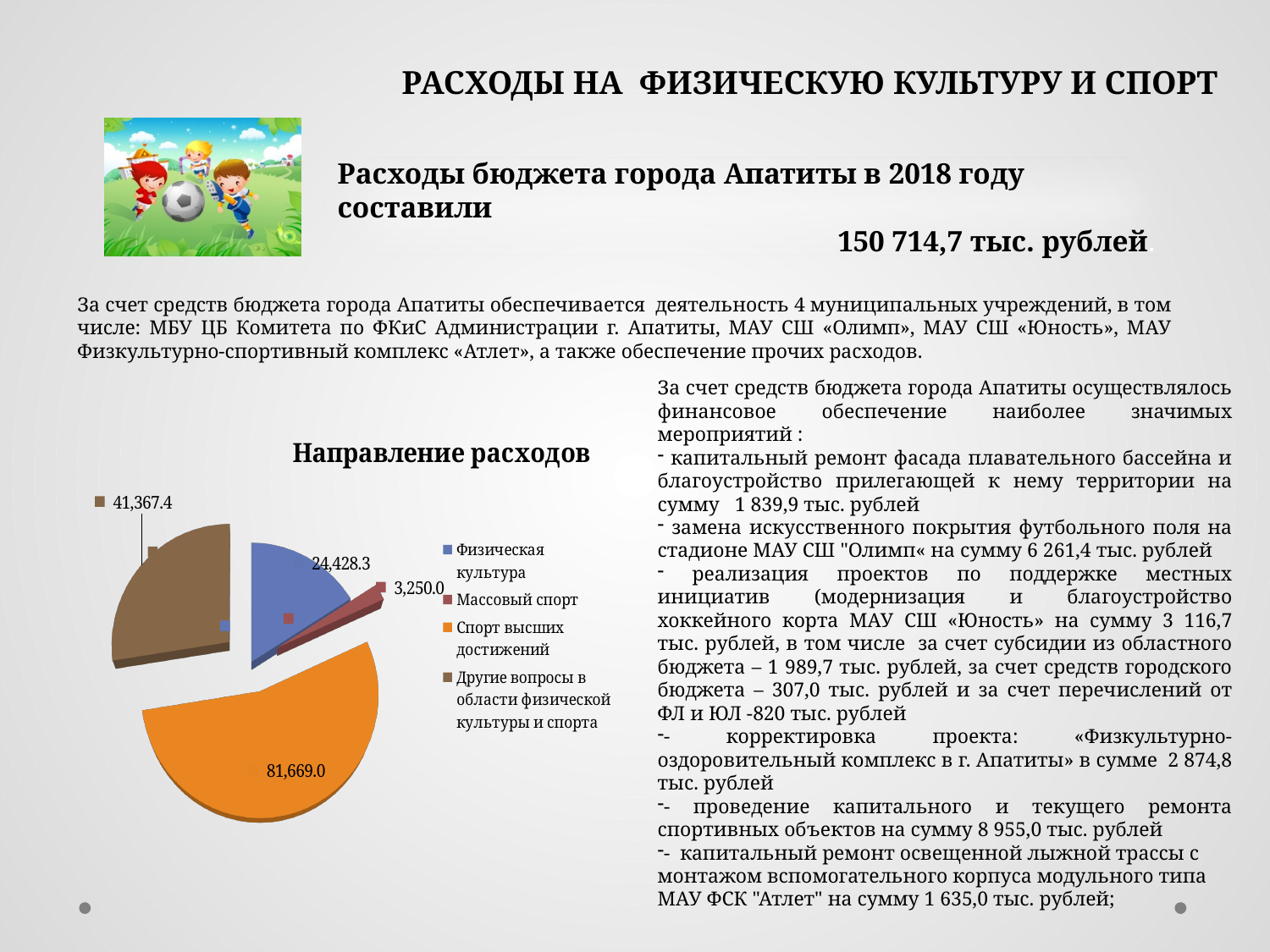
What is the value for «Физическая культура» in the pie chart? 24,428.3 Which category has the smallest slice in the pie chart? Массовый спорт What is the value for «Другие вопросы в области физической культуры и спорта» in the pie chart? 41,367.4 What is the value for «Спорт высших достижений» in the pie chart? 81,669.0 Which is larger in the pie chart: «Физическая культура» or «Другие вопросы в области физической культуры и спорта»? Другие вопросы в области физической культуры и спорта Which category has the largest slice in the pie chart? Спорт высших достижений What is the difference between the values for «Спорт высших достижений» and «Другие вопросы в области физической культуры и спорта»? 40,301.6 What colour is the slice for «Спорт высших достижений» in the pie chart? orange What type of chart is shown under the title «Направление расходов»? pie chart How many categories does the pie chart show? 4 What is the value for «Массовый спорт» in the pie chart? 3,250.0 What is the difference between the values for «Физическая культура» and «Массовый спорт»? 21,178.3